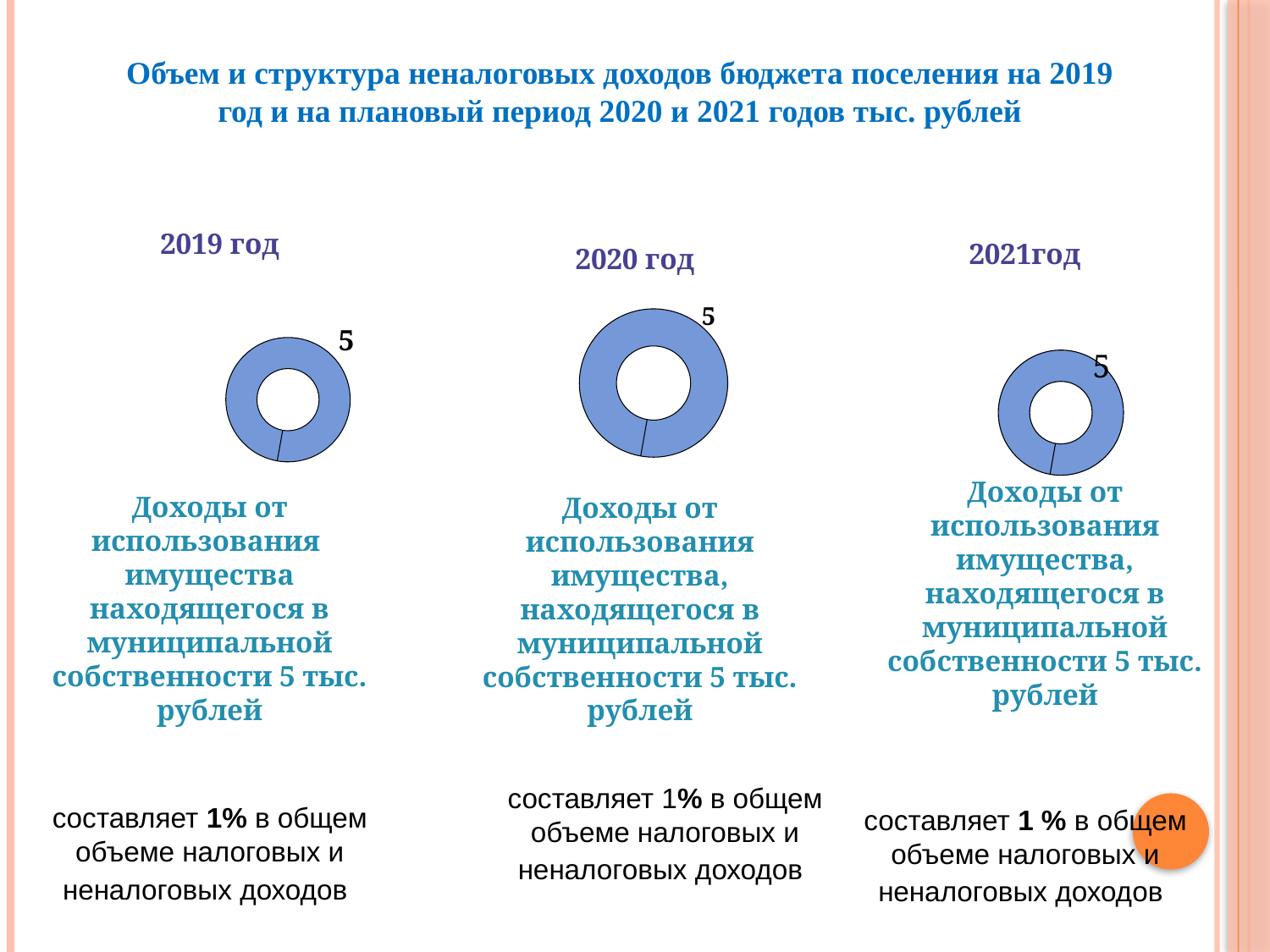
What share of the "2019 год" doughnut does its single slice occupy? 100% What kind of chart is shown under the heading "2019 год"? doughnut (pie) chart In the "2019 год" chart, what value is printed on the slice? 5 What colour are the slices in the three doughnut charts? blue In the "2021год" chart, what value is printed on the slice? 5 Does the plotted value change from the "2019 год" chart to the "2021год" chart? No, it stays at 5 How many slices does the "2020 год" chart contain? 1 In the "2020 год" chart, what value is printed on the slice? 5 How many doughnut charts are shown on the slide? 3 What category does the slice in the "2020 год" chart represent, according to the label below it? Доходы от использования имущества, находящегося в муниципальной собственности 5 тыс. рублей What is the difference between the value in the "2019 год" chart and the value in the "2021год" chart? 0